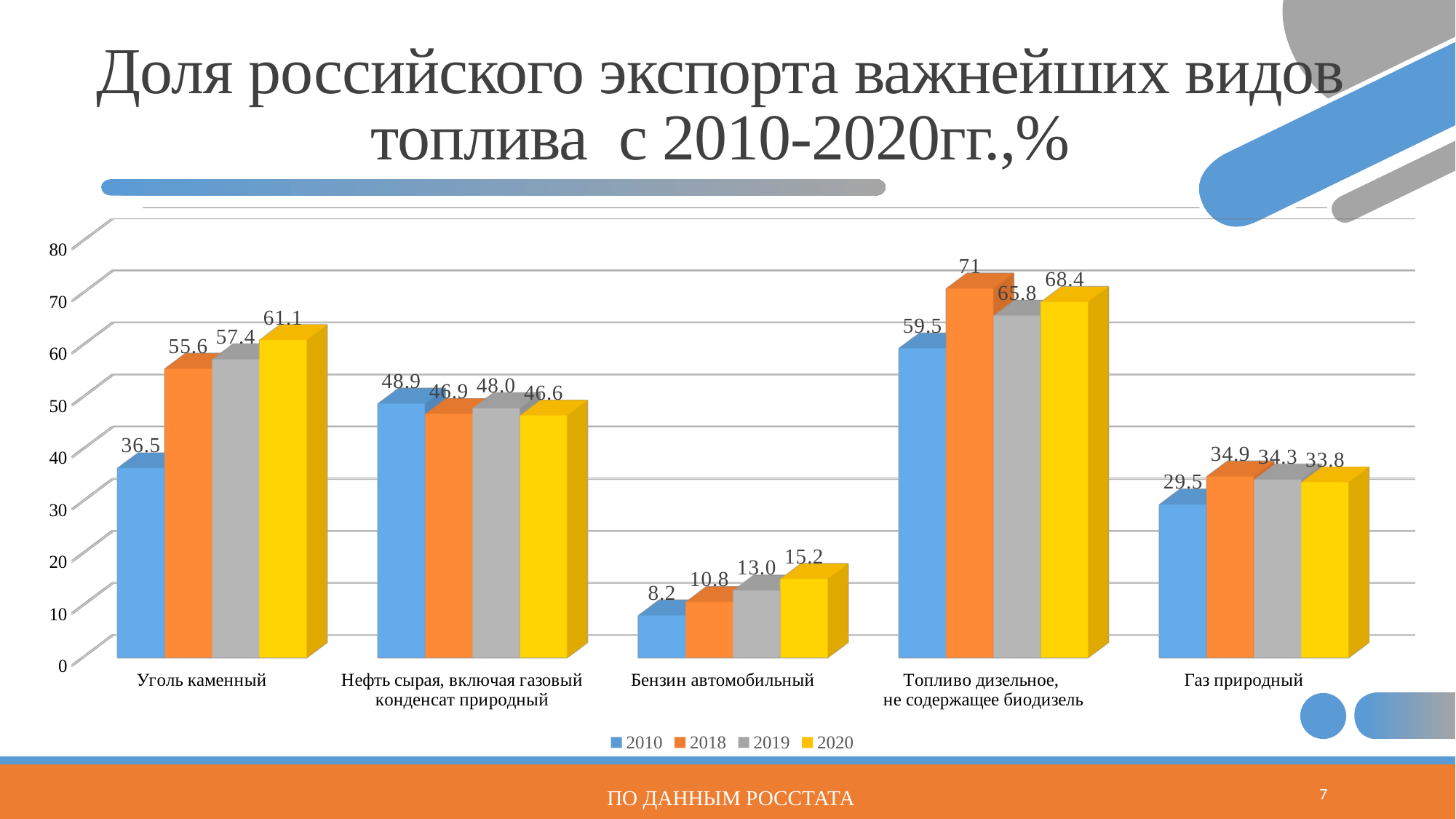
Which category has the lowest value in 2020? Бензин автомобильный What is the value for Бензин автомобильный in 2010? 8.2 Do the values for Бензин автомобильный rise or fall from 2010 to 2020? rise How many series does the legend list? 4 Which category has the highest value in 2019? Топливо дизельное, не содержащее биодизель What is the difference between the 2020 and 2010 values for Уголь каменный? 24.6 Which colour represents the 2018 series in the legend? orange What is the value for Топливо дизельное, не содержащее биодизель in 2018? 71 Which is larger: the 2010 value for Нефть сырая, включая газовый конденсат природный or the 2010 value for Газ природный? Нефть сырая, включая газовый конденсат природный What type of chart is shown on the slide? bar chart What is the value for Уголь каменный in 2020? 61.1 How many fuel categories are shown on the x axis? 5